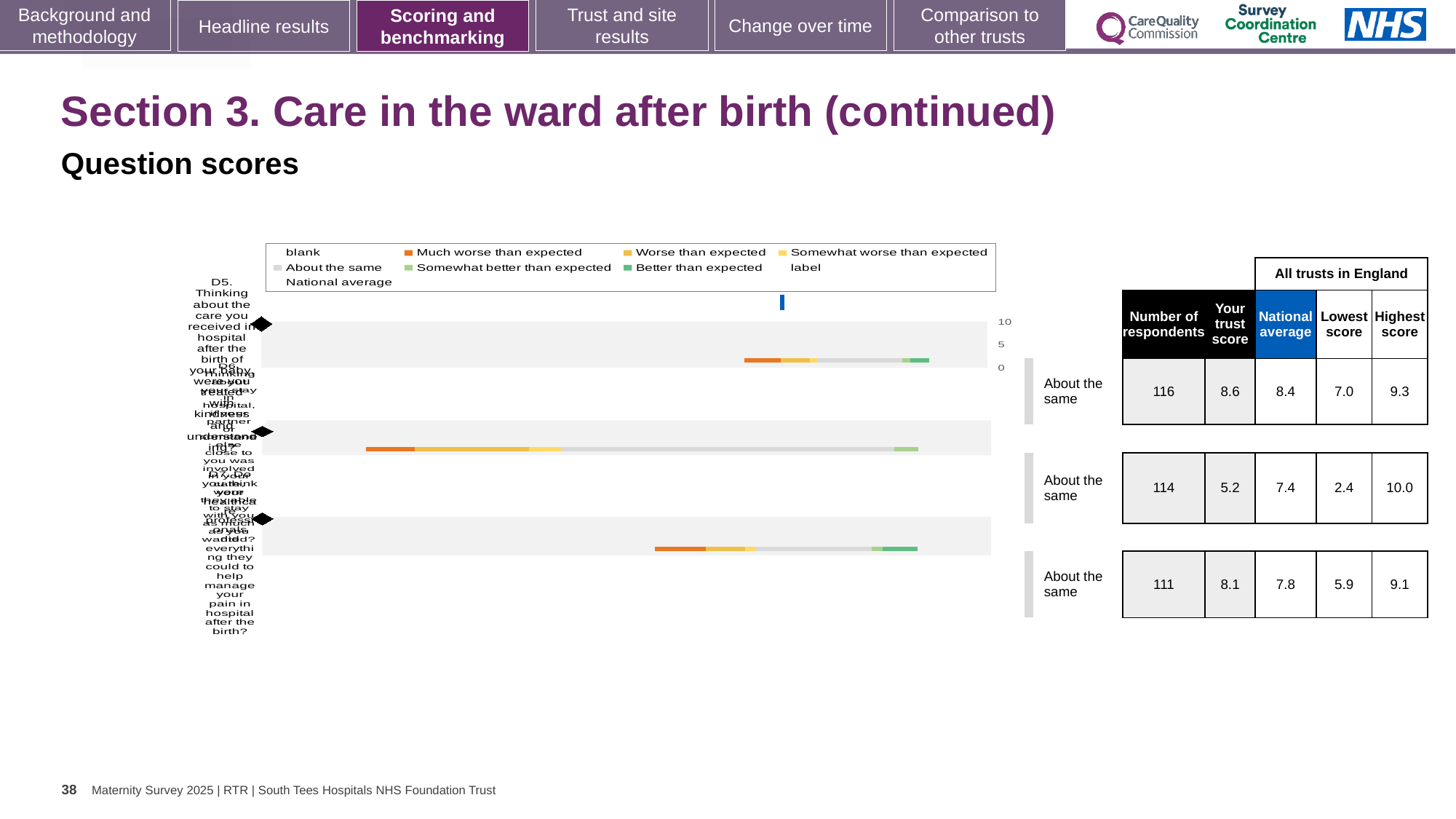
In the table to the right of the chart, what is the difference between 'Your trust score' and the national average for the top row? 0.2 What kind of chart is shown on the slide? bar chart How many entries does the chart's legend list? 9 In the table to the right of the chart, for the third row, which is larger: 'Your trust score' or the national average? Your trust score In the table to the right of the chart, what is the national average for the third row? 7.8 What colour does the legend use for 'About the same'? grey What colour does the legend use for 'Much worse than expected'? orange In the table to the right of the chart, what is the number of respondents for the top row? 116 In the table to the right of the chart, what is 'Your trust score' for the second row? 5.2 In the table to the right of the chart, which row has the lowest value in the 'Lowest score' column? the second row (2.4) How many question rows (bars) are plotted in the chart? 3 In the table to the right of the chart, which row has the highest value in the 'Highest score' column? the second row (10.0)